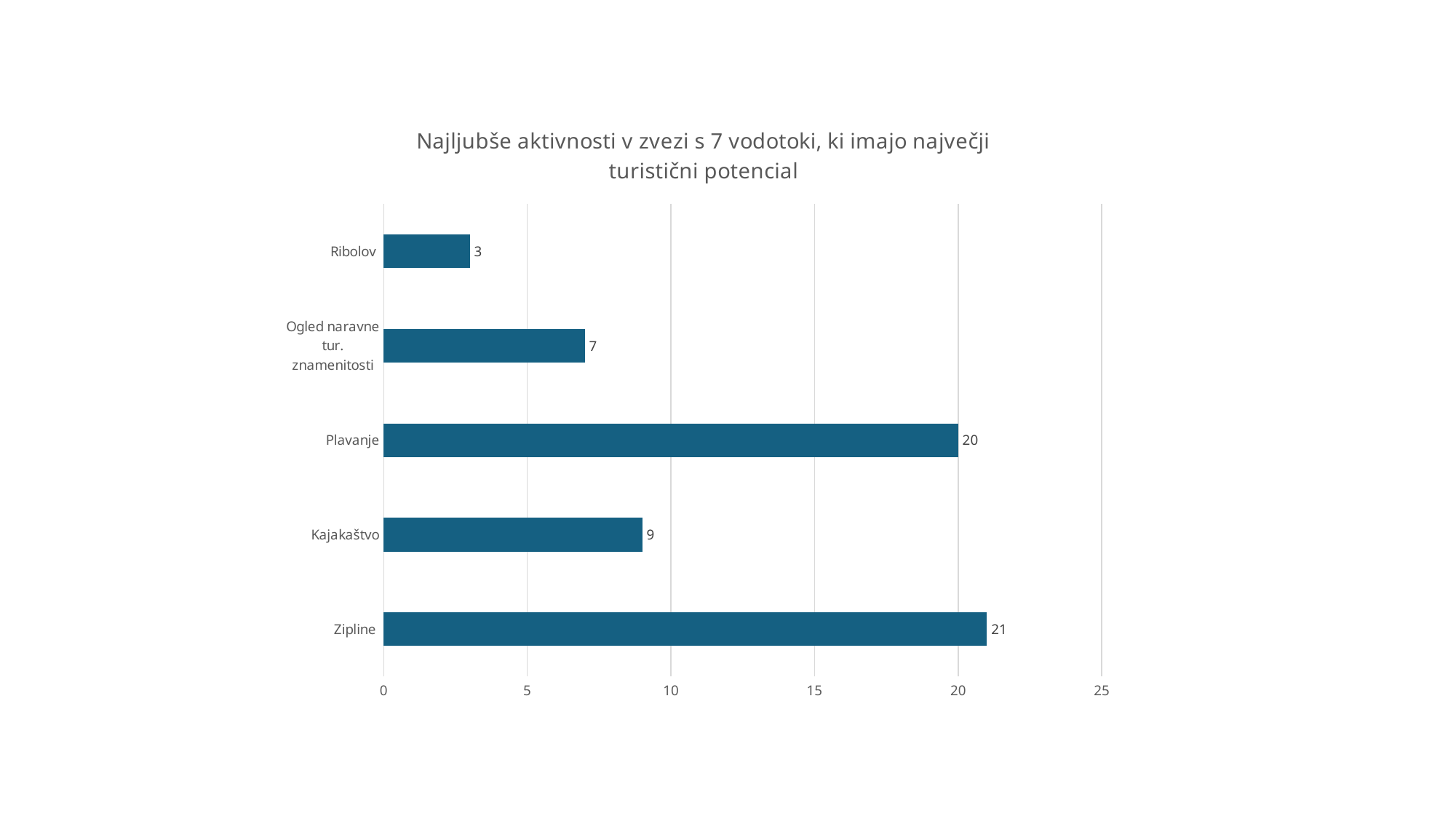
What is the value for Zipline? 21 Which activity has the lowest value? Ribolov Is the value for Plavanje greater or less than 15? greater What is the value for Ogled naravne tur. znamenitosti? 7 How many activities are shown in the chart? 5 Which activity has the highest value? Zipline What is the value for Plavanje? 20 What is the difference between the values for Kajakaštvo and Ribolov? 6 What is the value for Ribolov? 3 What is the title of the chart? Najljubše aktivnosti v zvezi s 7 vodotoki, ki imajo največji turistični potencial Which is larger, the value for Kajakaštvo or the value for Ogled naravne tur. znamenitosti? Kajakaštvo What kind of chart is shown on the slide? bar chart